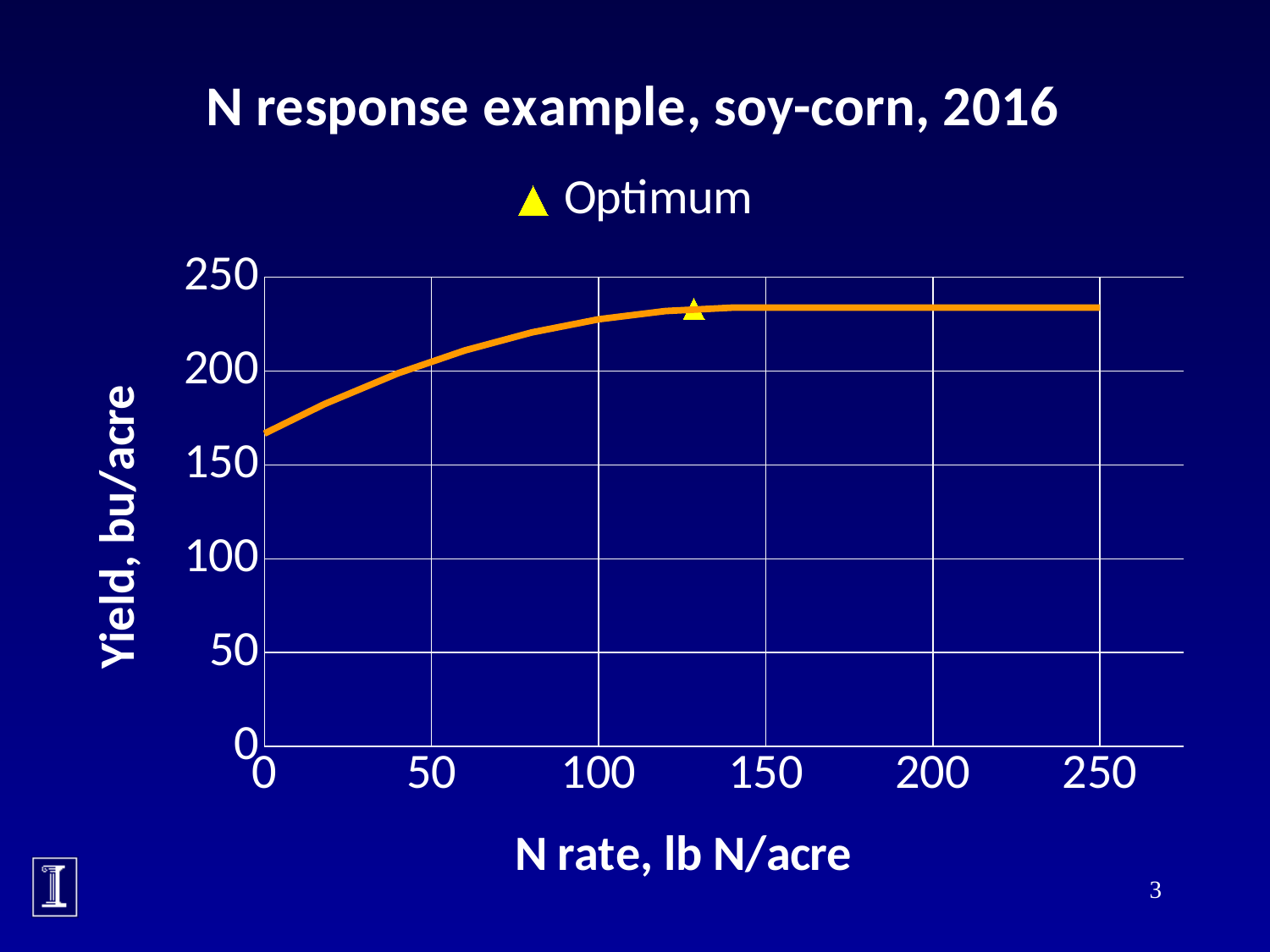
Is the yield at an N rate of 0 greater or less than 200 bu/acre? less What is the label of the vertical axis? Yield, bu/acre Is the yield at an N rate of 0 greater or less than 150 bu/acre? greater Which is larger, the yield at an N rate of 50 or the yield at an N rate of 200? 200 What kind of chart is shown on the slide? line chart Is the yield at the Optimum marker greater or less than 200 bu/acre? greater Does the yield rise or fall as the N rate increases from 0 to 100 lb N/acre? rise What is the title of the chart on the slide? N response example, soy-corn, 2016